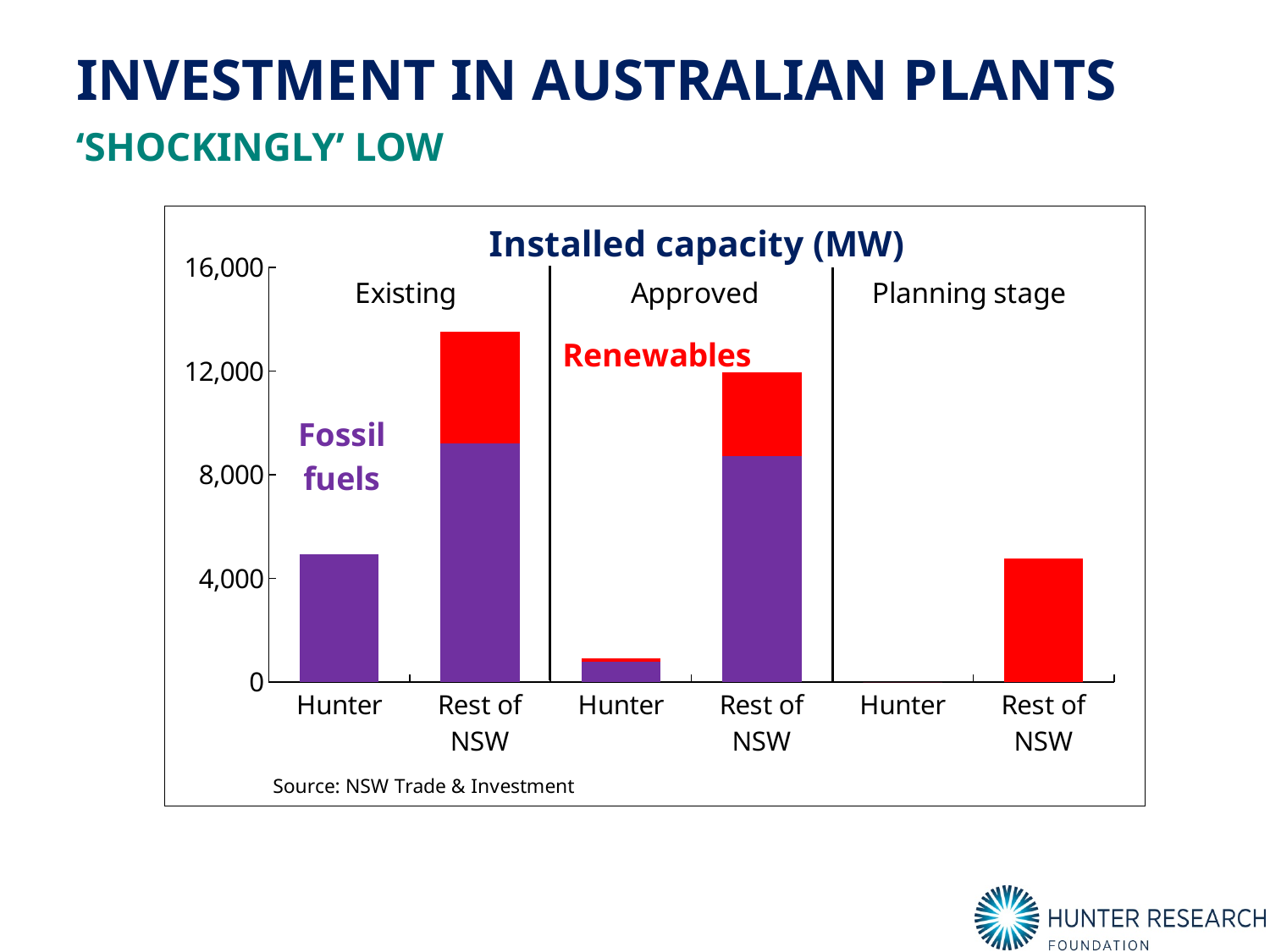
How many series does the chart show? 2 Is the installed capacity for Rest of NSW in the Planning stage group greater or less than 4,000? greater Which colour represents Renewables in the chart? Red Is the total installed capacity for Rest of NSW in the Existing group greater or less than 12,000? greater How many bars (category positions) are plotted on the chart? 6 Which bar has the lowest installed capacity? Hunter (Planning stage) Which is larger: the installed capacity for Hunter in the Existing group or Hunter in the Approved group? Hunter (Existing) Which bar has the highest total installed capacity? Rest of NSW (Existing) Is the installed capacity for Hunter in the Existing group greater or less than 4,000? greater What is the title of the chart? Installed capacity (MW) What kind of chart is shown on the slide? Stacked bar chart